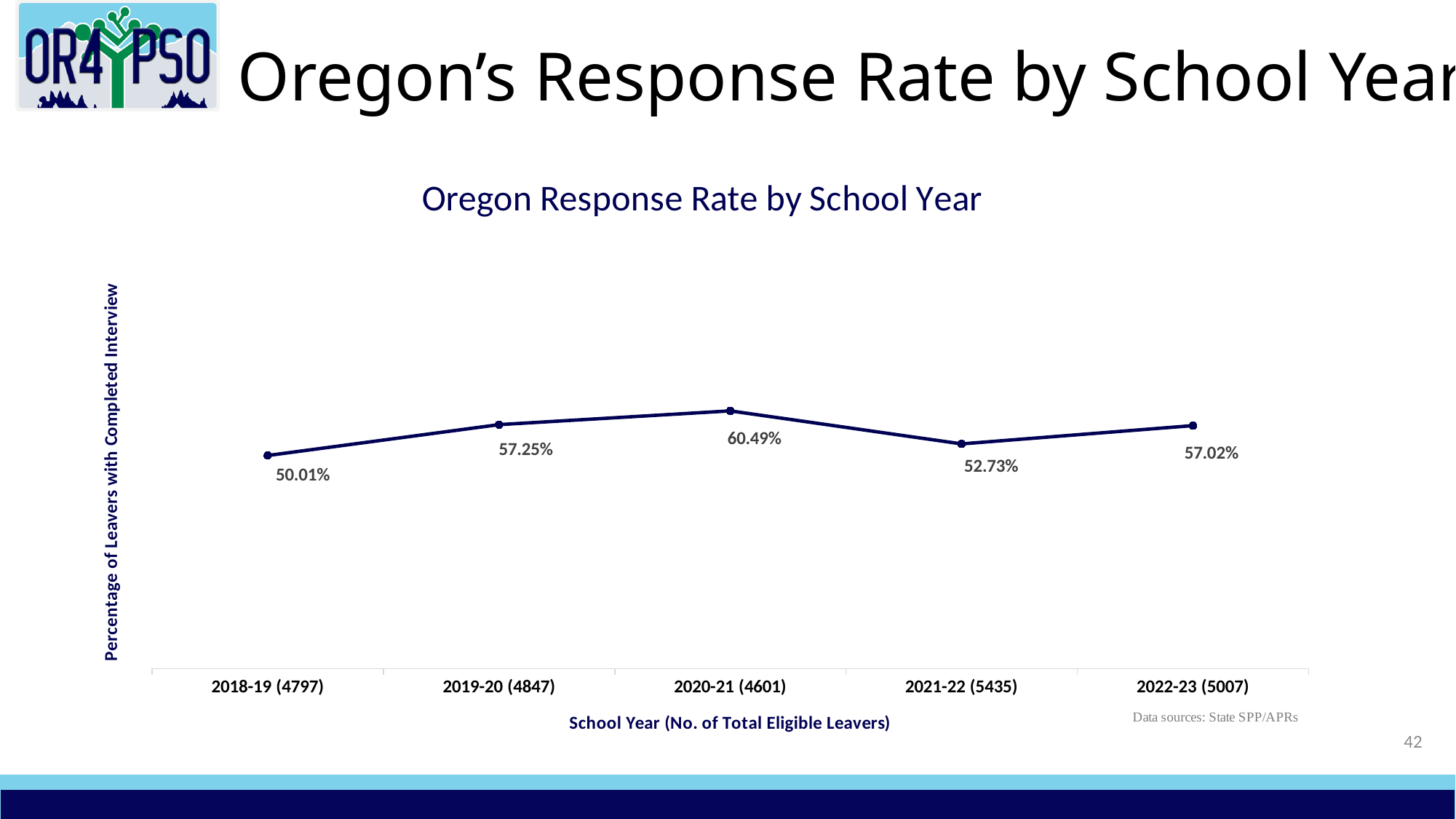
Which has a higher response rate, 2019-20 (4847) or 2021-22 (5435)? 2019-20 (4847) What is the response rate for 2022-23 (5007)? 57.02% What is the label of the x axis? School Year (No. of Total Eligible Leavers) What is the title of the chart? Oregon Response Rate by School Year What is the response rate for 2018-19 (4797)? 50.01% Does the response rate rise or fall from 2018-19 (4797) to 2020-21 (4601)? Rise What kind of chart is shown on the slide? Line chart How many school years are plotted on the chart? 5 Which school year has the lowest response rate? 2018-19 (4797) What is the difference between the response rates for 2020-21 (4601) and 2021-22 (5435)? 7.76% What is the response rate for 2020-21 (4601)? 60.49% Which school year has the highest response rate? 2020-21 (4601)